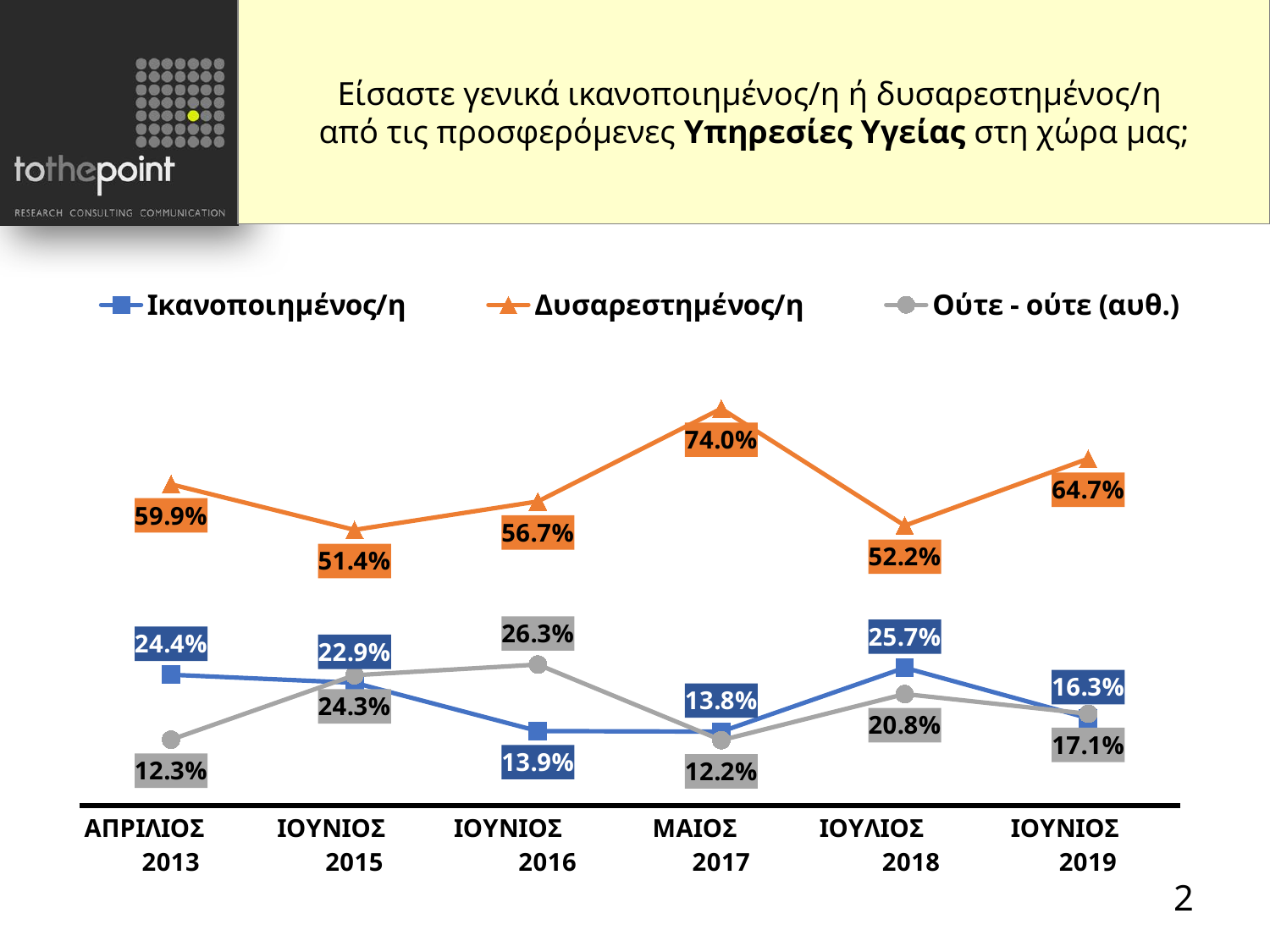
How many time points are plotted along the x axis? 6 What is the value for Ικανοποιημένος/η in ΙΟΥΛΙΟΣ 2018? 25.7% What type of chart is shown on the slide? line chart How many series does the legend list? 3 Does the Δυσαρεστημένος/η value rise or fall from ΙΟΥΛΙΟΣ 2018 to ΙΟΥΝΙΟΣ 2019? rise In which time point is the Ούτε - ούτε (αυθ.) value lowest? ΜΑΙΟΣ 2017 In which time point is the Δυσαρεστημένος/η value lowest? ΙΟΥΝΙΟΣ 2015 In which time point is the Δυσαρεστημένος/η value highest? ΜΑΙΟΣ 2017 What is the difference between the Δυσαρεστημένος/η values in ΜΑΙΟΣ 2017 and ΙΟΥΛΙΟΣ 2018? 21.8% What is the value for Ούτε - ούτε (αυθ.) in ΙΟΥΝΙΟΣ 2016? 26.3% What is the value for Δυσαρεστημένος/η in ΜΑΙΟΣ 2017? 74.0% Which is larger in ΙΟΥΝΙΟΣ 2016: the Ικανοποιημένος/η value or the Ούτε - ούτε (αυθ.) value? Ούτε - ούτε (αυθ.)